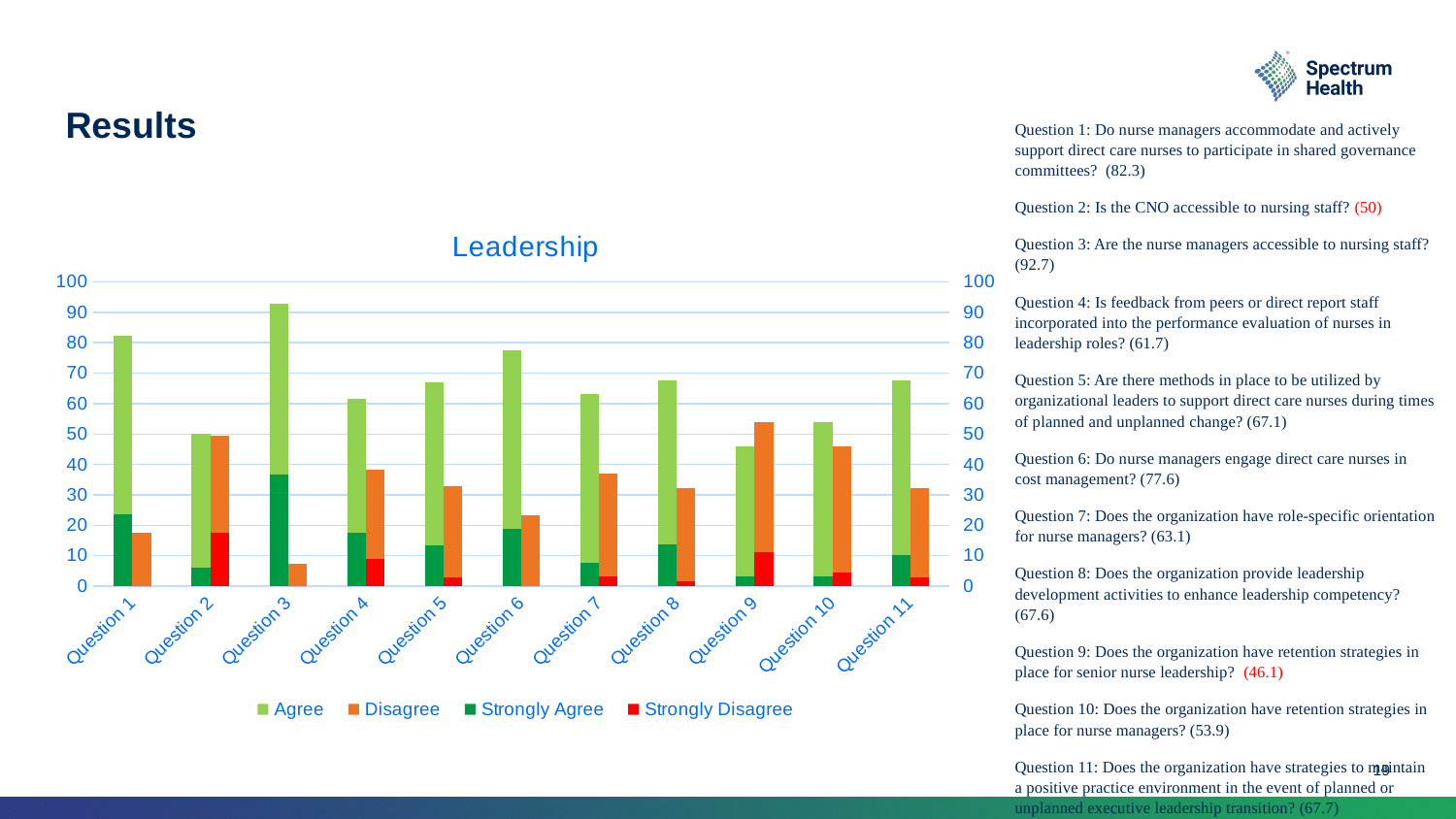
How many questions (categories) are shown along the x axis of the chart? 11 What kind of chart is shown on the slide? bar chart Is the top of the Agree stacked bar for Question 6 greater or less than 70? greater Is the top of the Agree stacked bar for Question 9 greater or less than 50? less What is the title of the chart? Leadership Which question has the tallest Agree stacked bar in the chart? Question 3 For Question 9, which stacked bar is taller, the Agree bar or the Disagree bar? Disagree Is the Strongly Agree segment for Question 3 greater or less than 30? greater Which question has the tallest Strongly Agree segment in the chart? Question 3 For Question 1, which stacked bar is taller, the Agree bar or the Disagree bar? Agree How many series does the chart's legend list? 4 Which colour represents the Agree series in the chart? light green